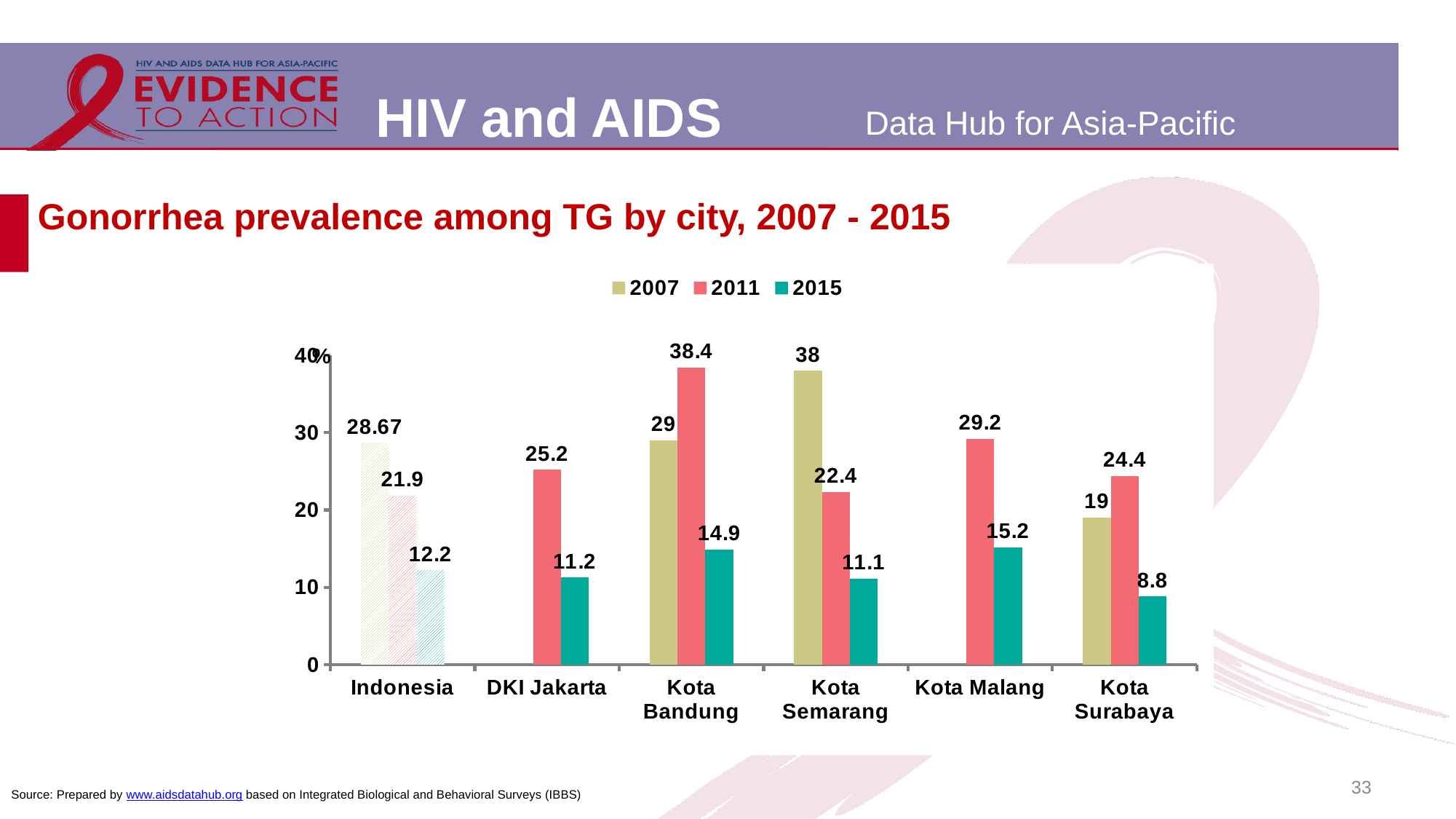
How many series does the legend list? 3 How many categories are shown on the x axis? 6 What is the 2015 value for Kota Surabaya? 8.8 Which city has the highest 2007 value? Kota Semarang What is the 2011 gonorrhea prevalence value for Kota Bandung? 38.4 Which is larger for Kota Semarang: the 2007 value or the 2011 value? 2007 Which city has no 2007 bar shown? DKI Jakarta and Kota Malang What is the title of the chart? Gonorrhea prevalence among TG by city, 2007 - 2015 What is the difference between the 2011 and 2015 values for Kota Malang? 14 Which category has the lowest 2015 value? Kota Surabaya What is the 2007 value for Indonesia? 28.67 What kind of chart is shown on the slide? Bar chart